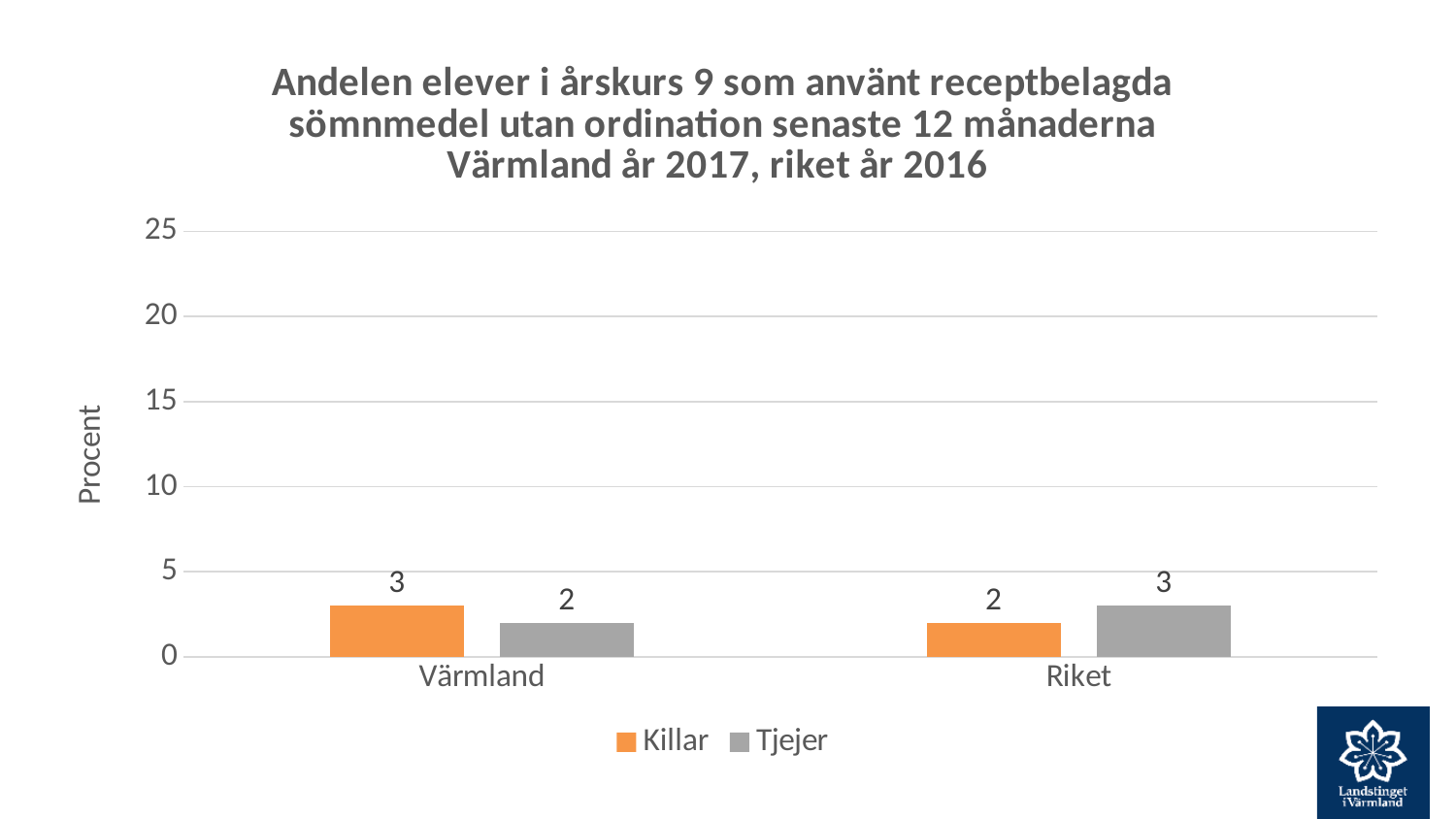
How many categories are shown on the x axis? 2 What is the value for Tjejer in Värmland? 2 What is the label of the y axis? Procent What is the difference between the Killar and Tjejer values in Värmland? 1 What kind of chart is shown on the slide? bar chart Is the value for Killar in Värmland greater or less than 5? less How many series does the legend list? 2 What is the value for Tjejer in Riket? 3 Which series has the higher value in Värmland, Killar or Tjejer? Killar What is the value for Killar in Riket? 2 What is the value for Killar in Värmland? 3 Which series has the higher value in Riket, Killar or Tjejer? Tjejer